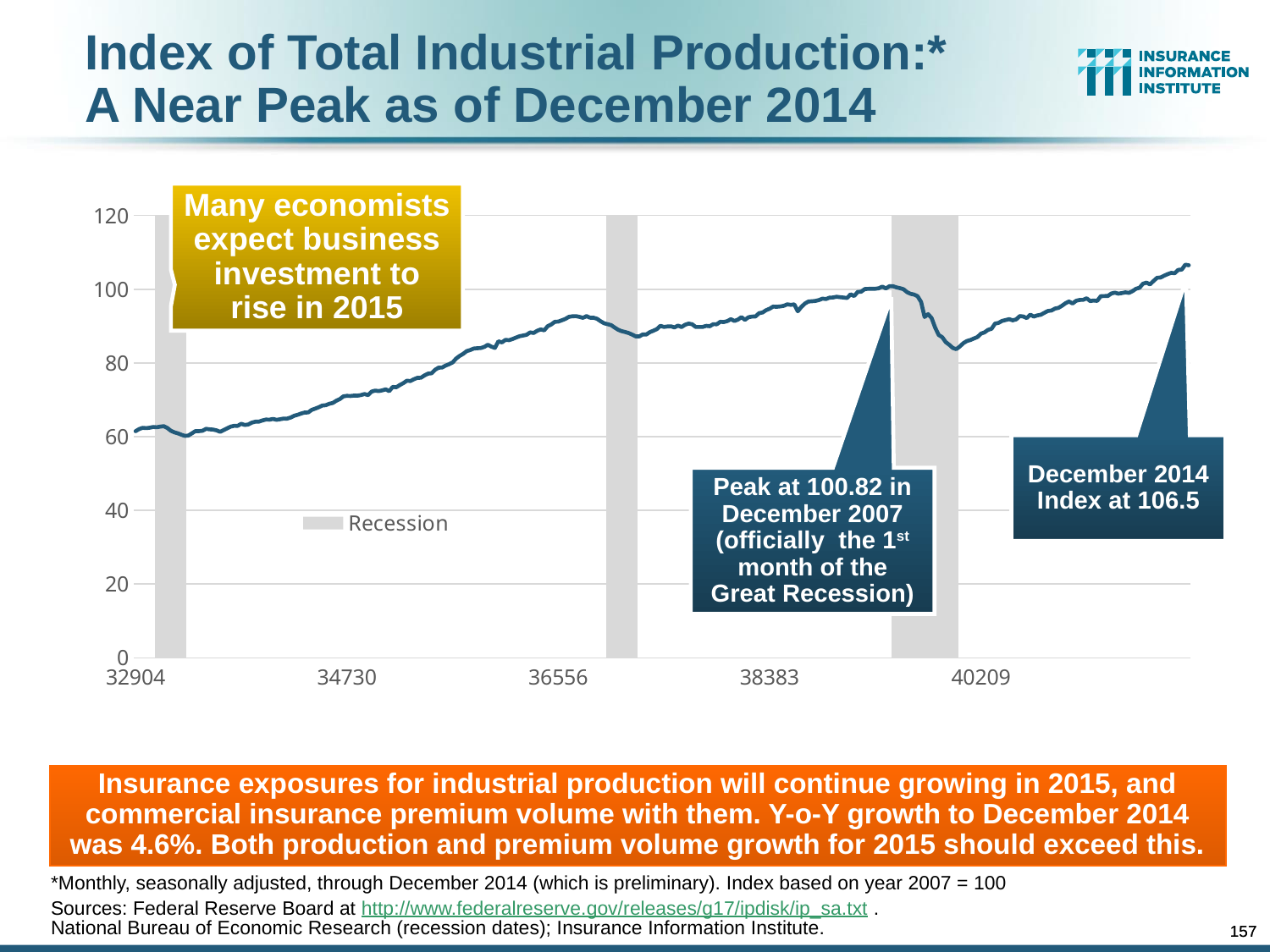
Is the lowest index value reached after the December 2007 peak greater or less than 100? less What was the Index of Total Industrial Production in December 2014? 106.5 What was the peak value of the index in December 2007? 100.82 What does the legend entry on the chart say? Recession What is the highest value labelled on the y axis? 120 Is the index value at the start of the series (x-axis label 32904) greater or less than 80? less How many grey shaded recession bands appear on the chart? 3 By how much does the December 2014 index value exceed the December 2007 peak? 5.68 Over the whole period shown, does the index generally rise or fall along the x axis? rise Is the index value at the x-axis label 38383 greater or less than 80? greater Which is higher: the index in December 2007 or the index in December 2014? December 2014 What kind of chart is shown on the slide? line chart